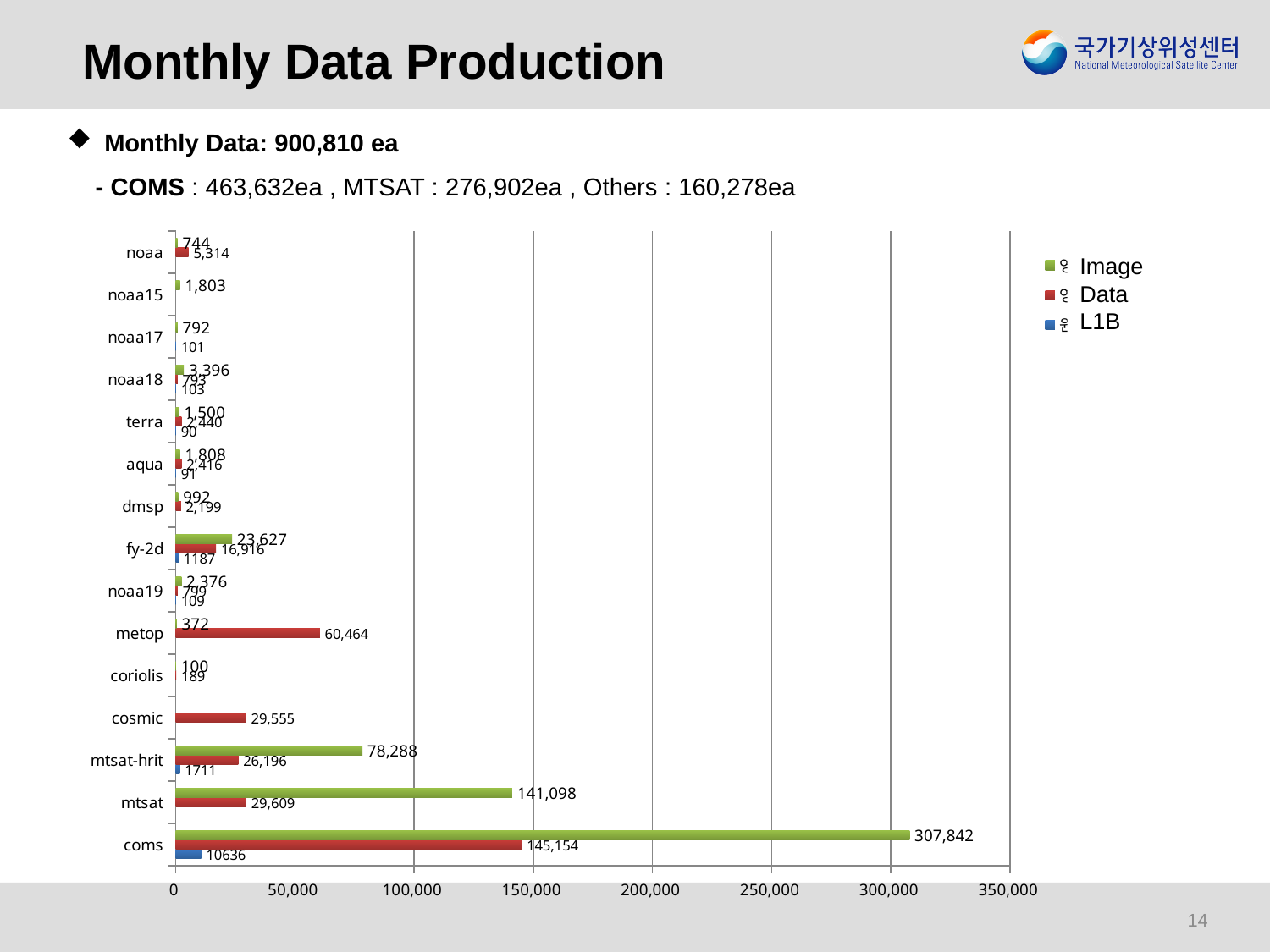
What is the difference between the Image value for coms and the Image value for mtsat? 166,744 How many series does the legend list? 3 Is the Data value for coms greater or less than 100,000? greater What is the Data value for metop? 60,464 What is the Data value for fy-2d? 16,916 Which is larger, the Data value for cosmic or the Data value for mtsat-hrit? cosmic What is the Image value for mtsat-hrit? 78,288 What type of chart is shown on the slide? bar chart What is the L1B value for coms? 10636 How many categories are plotted on the chart? 15 What is the Image value for coms? 307,842 Which category has the highest Image value? coms